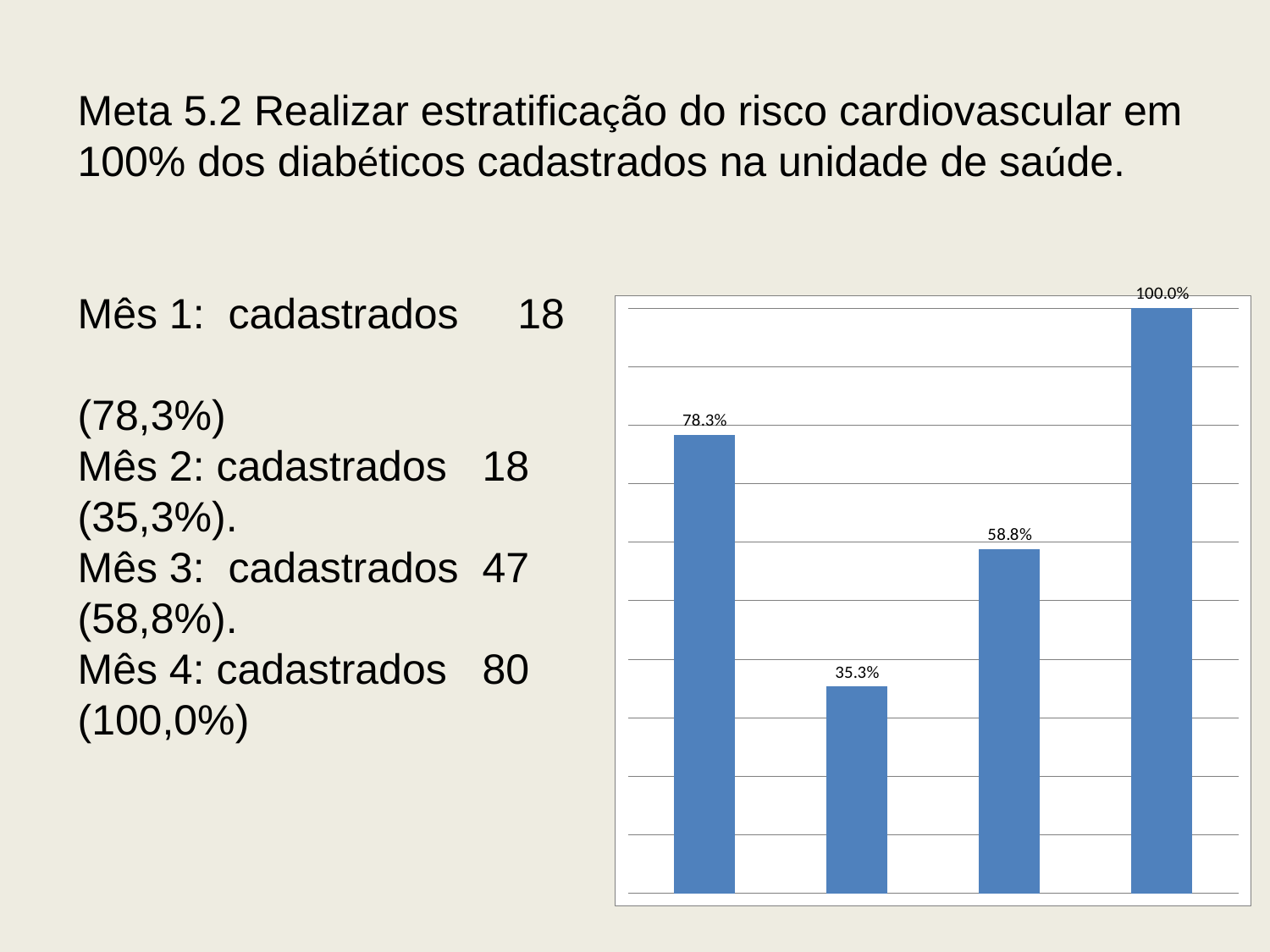
Do the values rise or fall from the second bar to the fourth bar? rise What value is labelled on the first (leftmost) bar of the chart? 78.3% What is the difference between the first bar (78.3%) and the second bar (35.3%)? 43.0% What is the difference between the fourth bar (100.0%) and the third bar (58.8%)? 41.2% Which bar in the chart has the highest value? the fourth (rightmost) bar, 100.0% What kind of chart is shown on the slide? bar chart What value is labelled on the second bar of the chart? 35.3% What value is labelled on the fourth (rightmost) bar of the chart? 100.0% What value is labelled on the third bar of the chart? 58.8% Which bar in the chart has the lowest value? the second bar, 35.3% Which is larger, the value of the first bar or the value of the third bar? the first bar (78.3%) How many bars are plotted in the chart? 4